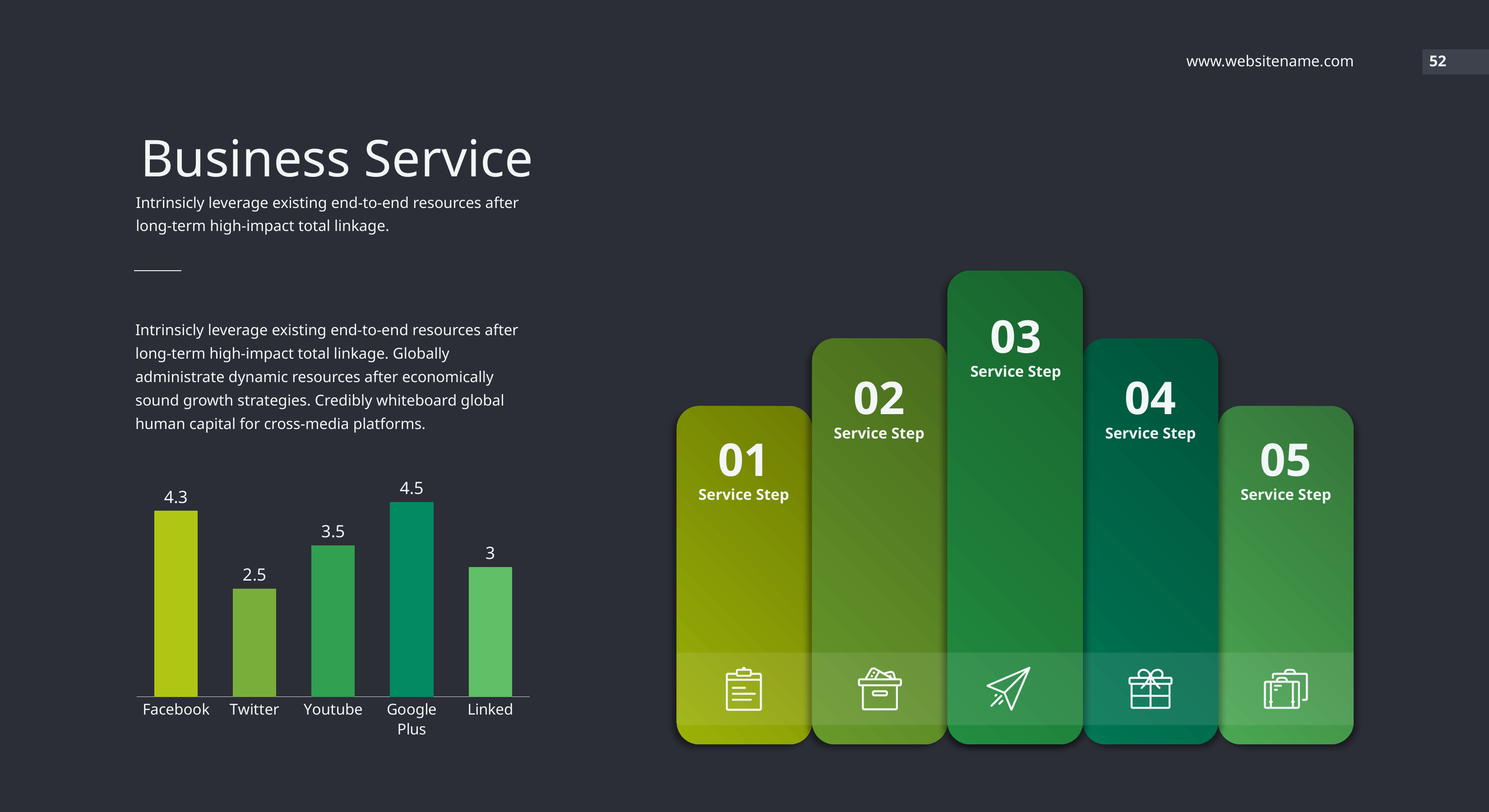
What is the difference between the values for Facebook and Linked? 1.3 What is the value for Linked? 3 Which category has the highest value? Google Plus What is the value for Google Plus? 4.5 What is the value for Twitter? 2.5 Which is larger, the value for Youtube or the value for Linked? Youtube What is the value for Youtube? 3.5 What is the value for Facebook? 4.3 Which category has the lowest value? Twitter How many categories are shown in the chart? 5 What is the difference between the values for Google Plus and Twitter? 2 What kind of chart is shown on the slide? Bar chart